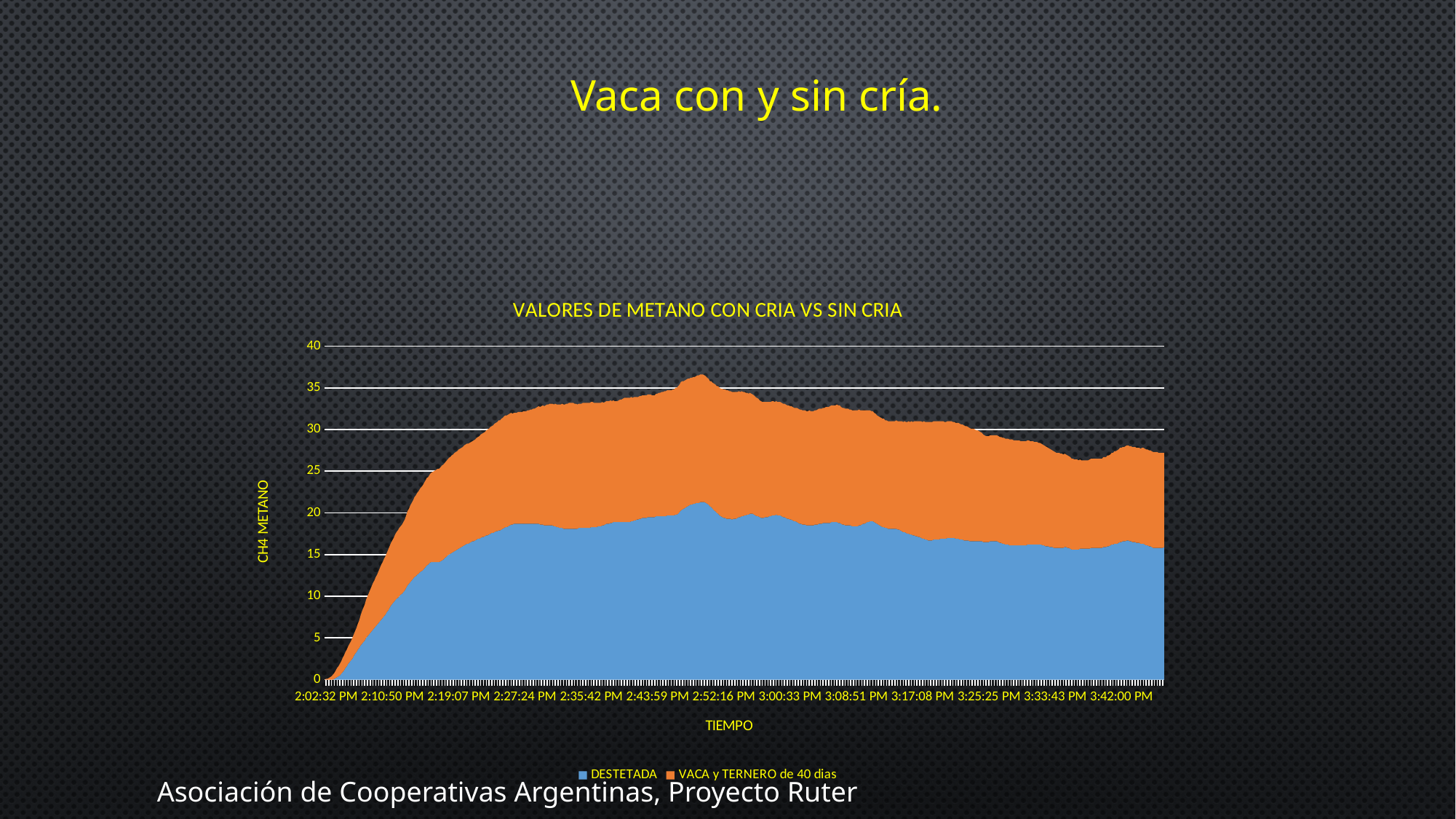
Is the value for DESTETADA at 2:02:32 PM greater or less than 5? less Which series is shown in blue? DESTETADA What is the label of the vertical axis? CH4 METANO Is the stacked total at 3:42:00 PM greater or less than 30? less Does the stacked total rise or fall between 2:52:16 PM and 3:42:00 PM? fall Does the DESTETADA series rise or fall between 2:02:32 PM and 2:27:24 PM? rise What kind of chart is shown on the slide? Stacked area chart How many series does the legend list? 2 What is the title of the chart? VALORES DE METANO CON CRIA VS SIN CRIA Is the value for DESTETADA at 2:27:24 PM greater or less than 20? less